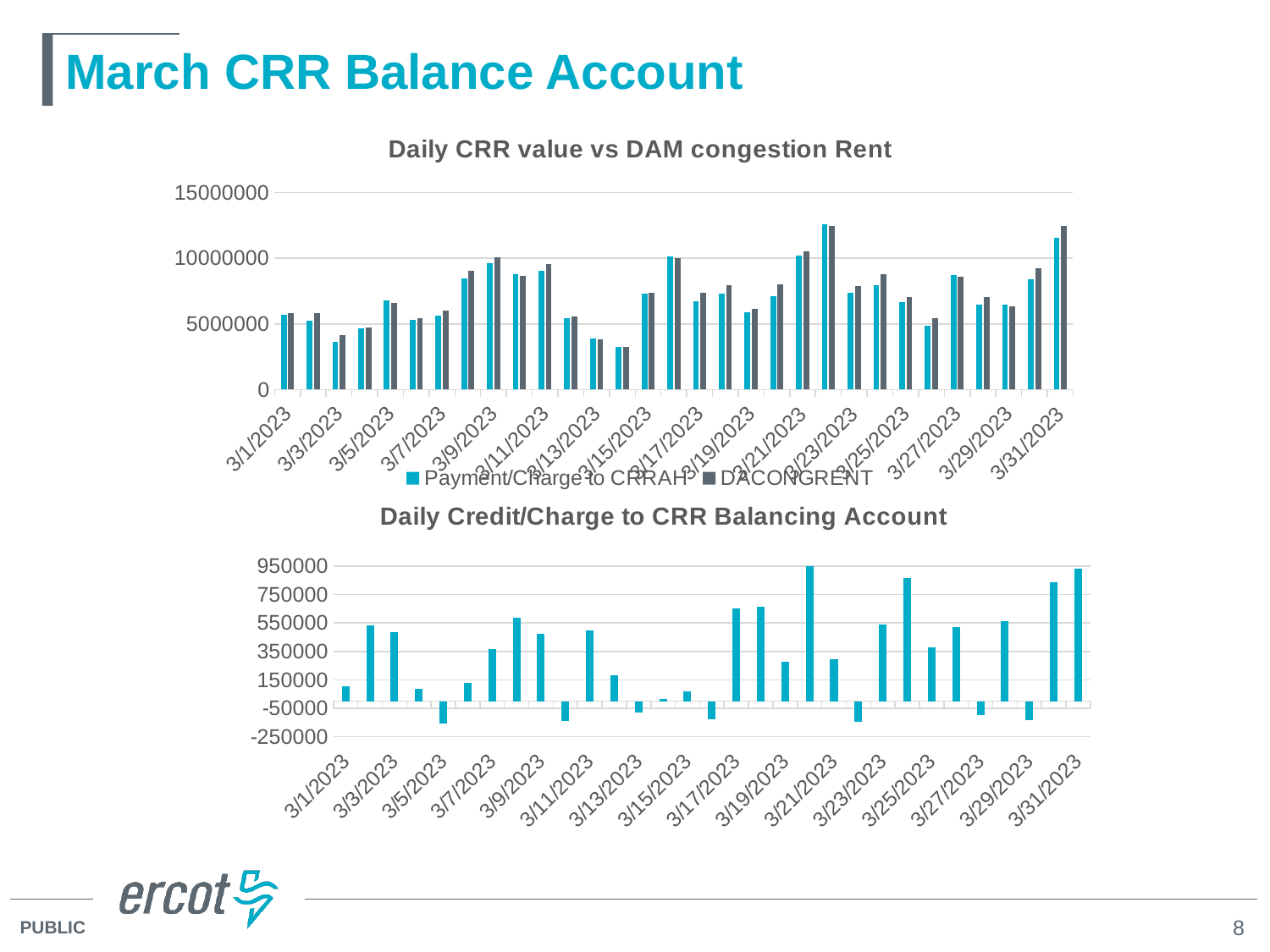
What kind of chart is the bottom chart titled 'Daily Credit/Charge to CRR Balancing Account'? bar chart In the top chart 'Daily CRR value vs DAM congestion Rent', is the Payment/Charge to CRRAH value for 3/13/2023 greater or less than 5000000? less What kind of chart is the top chart titled 'Daily CRR value vs DAM congestion Rent'? bar chart In the bottom chart 'Daily Credit/Charge to CRR Balancing Account', is the value for 3/5/2023 greater or less than -50000? less In the bottom chart 'Daily Credit/Charge to CRR Balancing Account', is the value for 3/31/2023 greater or less than 750000? greater In the top chart 'Daily CRR value vs DAM congestion Rent', how many series does the legend list? 2 In the top chart 'Daily CRR value vs DAM congestion Rent', what are the two series named in the legend? Payment/Charge to CRRAH and DACONGRENT What is the title of the top chart on the slide? Daily CRR value vs DAM congestion Rent